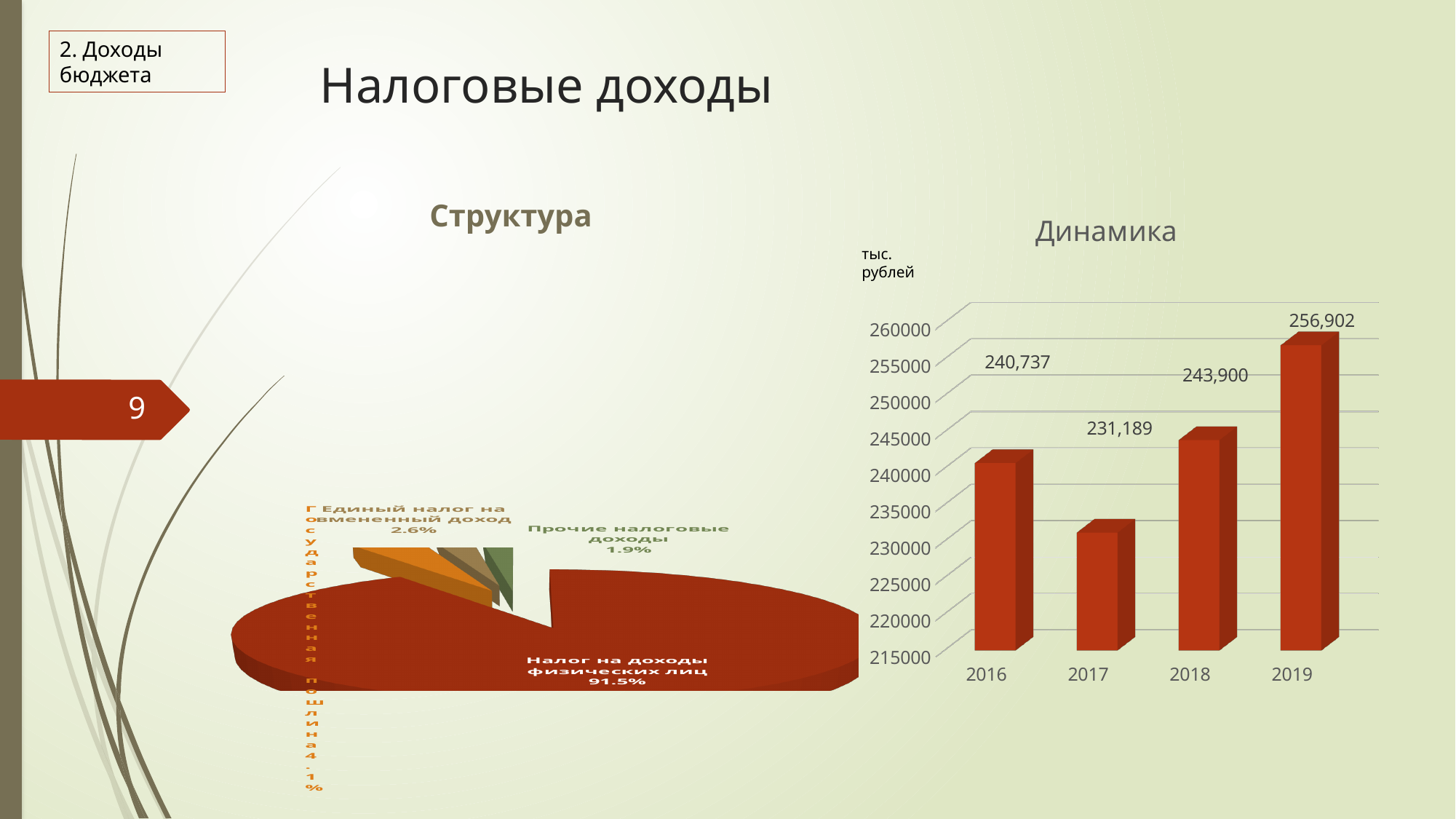
In the Структура chart, which category has the smallest slice? Прочие налоговые доходы In the Динамика chart, what is the value for 2017? 231,189 In the Динамика chart, what is the difference between the values for 2019 and 2016? 16,165 In the Динамика chart, what is the difference between the values for 2018 and 2017? 12,711 In the Структура chart, what share does Налог на доходы физических лиц have? 91.5% In the Динамика chart, which is larger, the value for 2018 or the value for 2016? 2018 In the Динамика chart, which year has the highest value? 2019 In the Динамика chart, do the values rise or fall from 2017 to 2019? rise What kind of chart is the Динамика chart? bar chart In the Динамика chart, how many years are shown on the x axis? 4 In the Динамика chart, what is the value for 2019? 256,902 In the Динамика chart, which year has the lowest value? 2017